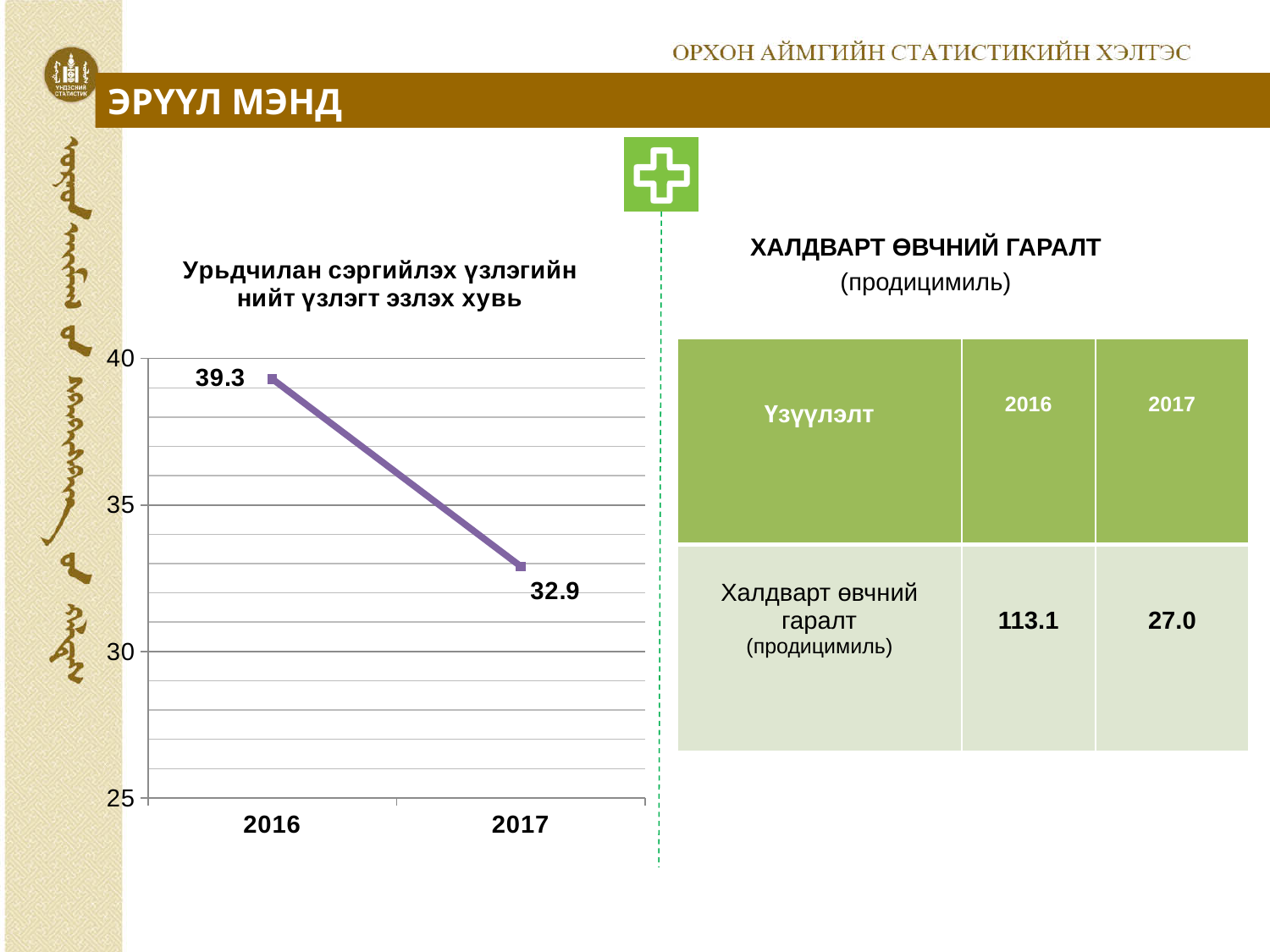
Which year has the lowest value in the chart? 2017 What is the value for 2017 in the chart? 32.9 What is the value for 2016 in the chart? 39.3 Is the value for 2017 in the chart greater or less than 35? less Do the values in the chart rise or fall from 2016 to 2017? fall Which is larger in the chart, the value for 2016 or the value for 2017? 2016 Is the value for 2016 in the chart greater or less than 35? greater Which year has the highest value in the chart? 2016 What is the difference between the 2016 and 2017 values in the chart? 6.4 How many data points are plotted in the chart? 2 What type of chart is shown on the slide? line chart What is the title of the chart? Урьдчилан сэргийлэх үзлэгийн нийт үзлэгт эзлэх хувь